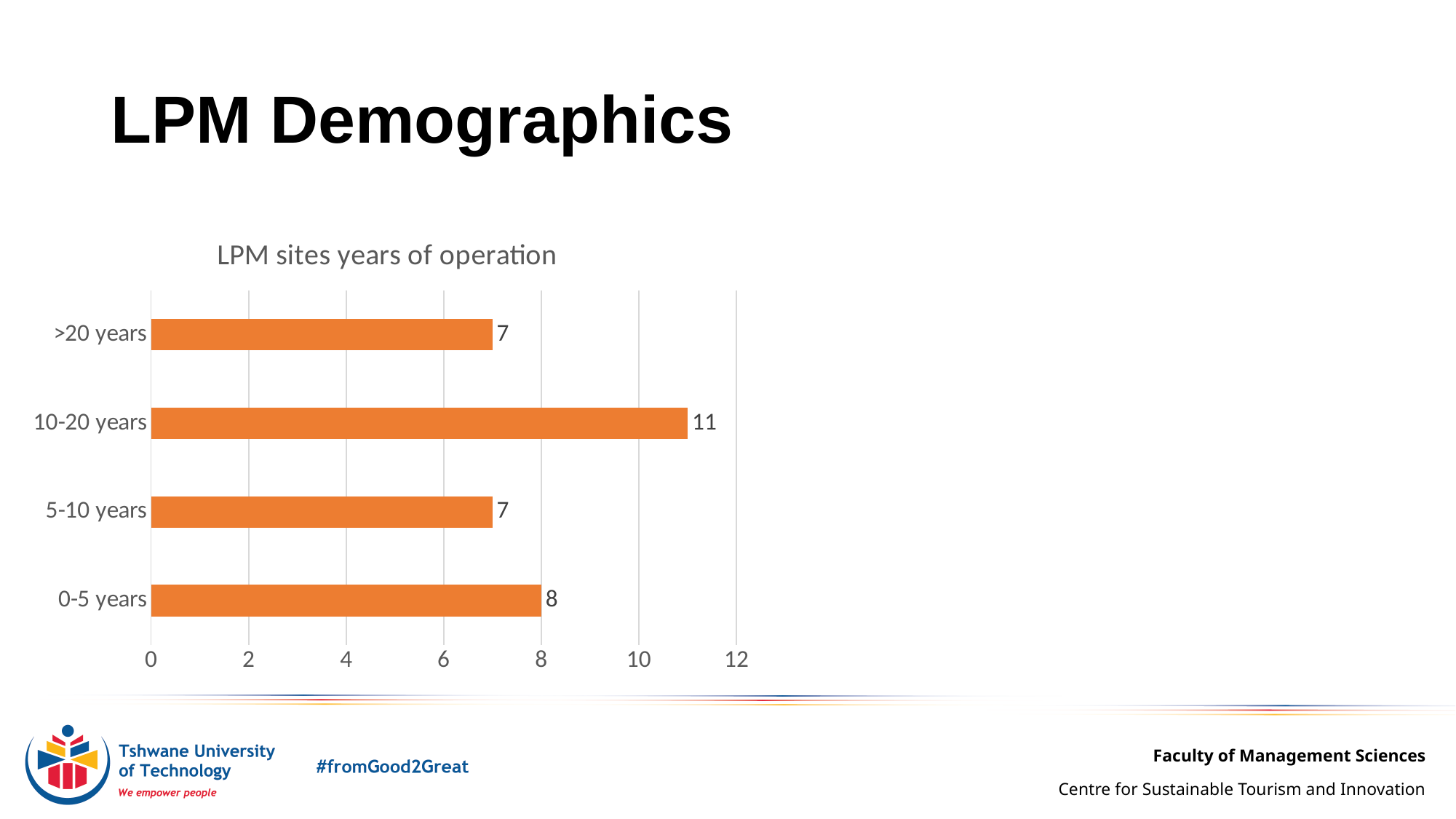
Which is larger, the value for 10-20 years or the value for >20 years? 10-20 years How many categories are shown in the chart? 4 What is the value for 0-5 years? 8 What is the difference between the values for 10-20 years and 0-5 years? 3 Which category has the highest value? 10-20 years What is the title of the chart? LPM sites years of operation What is the value for >20 years? 7 What is the value for 10-20 years? 11 What kind of chart is shown on the slide? bar chart Is the value for 10-20 years greater or less than 10? greater What colour are the bars in the chart? orange What is the difference between the values for 0-5 years and 5-10 years? 1